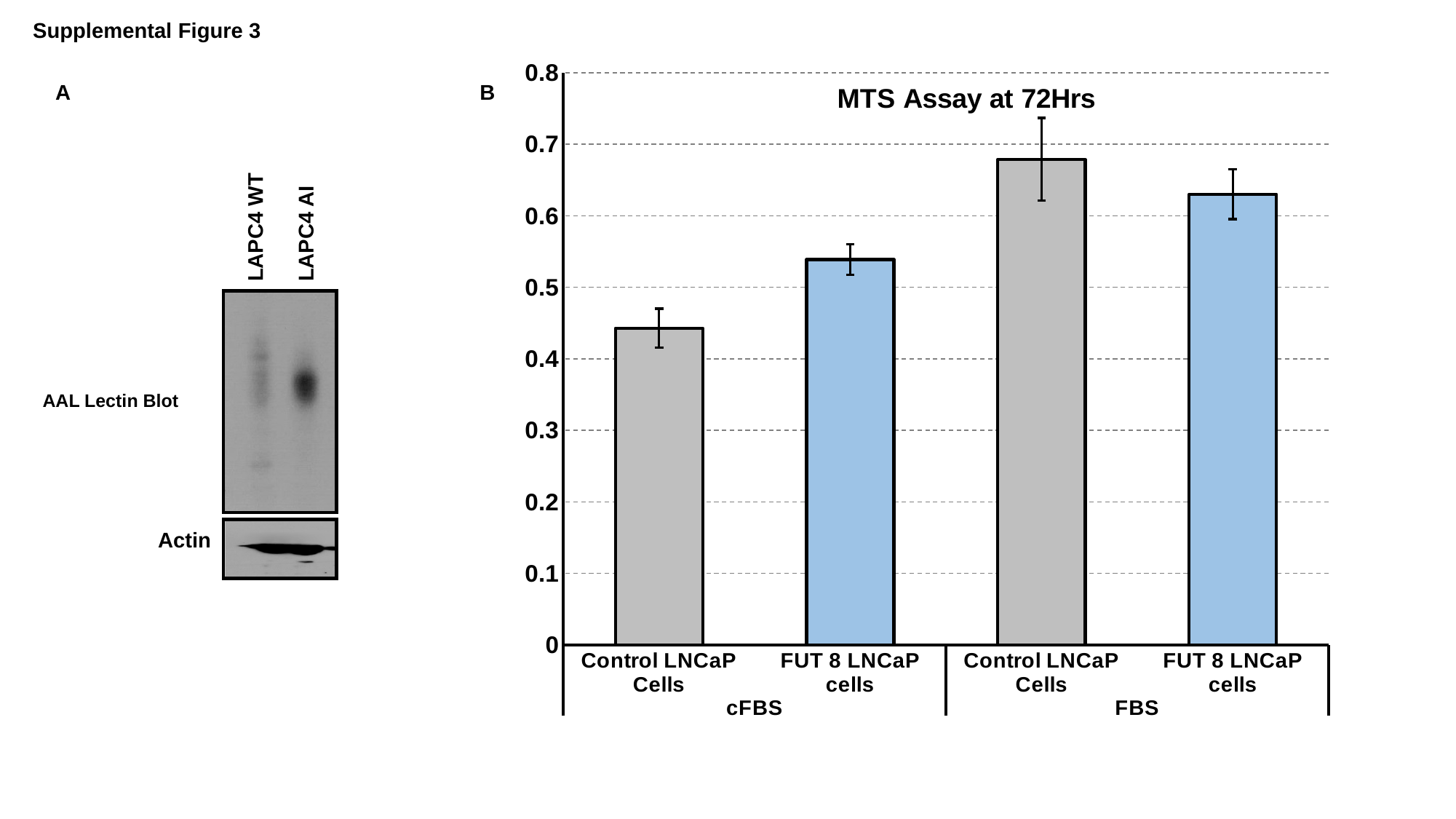
In the MTS Assay at 72Hrs chart, which bar is the lowest? Control LNCaP Cells (cFBS) In the MTS Assay at 72Hrs chart, is the value for Control LNCaP Cells under FBS greater or less than 0.6? greater In the MTS Assay at 72Hrs chart, what are the two serum condition groups labelled on the x axis? cFBS and FBS In the MTS Assay at 72Hrs chart, under cFBS, which is larger: Control LNCaP Cells or FUT 8 LNCaP cells? FUT 8 LNCaP cells What type of chart is shown in panel B? bar chart How many bars are plotted in the MTS Assay at 72Hrs chart? 4 What is the title of the chart in panel B? MTS Assay at 72Hrs In the MTS Assay at 72Hrs chart, which is larger: FUT 8 LNCaP cells under cFBS or FUT 8 LNCaP cells under FBS? FUT 8 LNCaP cells under FBS In the MTS Assay at 72Hrs chart, is the value for Control LNCaP Cells under FBS greater or less than 0.7? less In the MTS Assay at 72Hrs chart, is the value for Control LNCaP Cells under cFBS greater or less than 0.5? less In the MTS Assay at 72Hrs chart, which bar is the highest? Control LNCaP Cells (FBS)